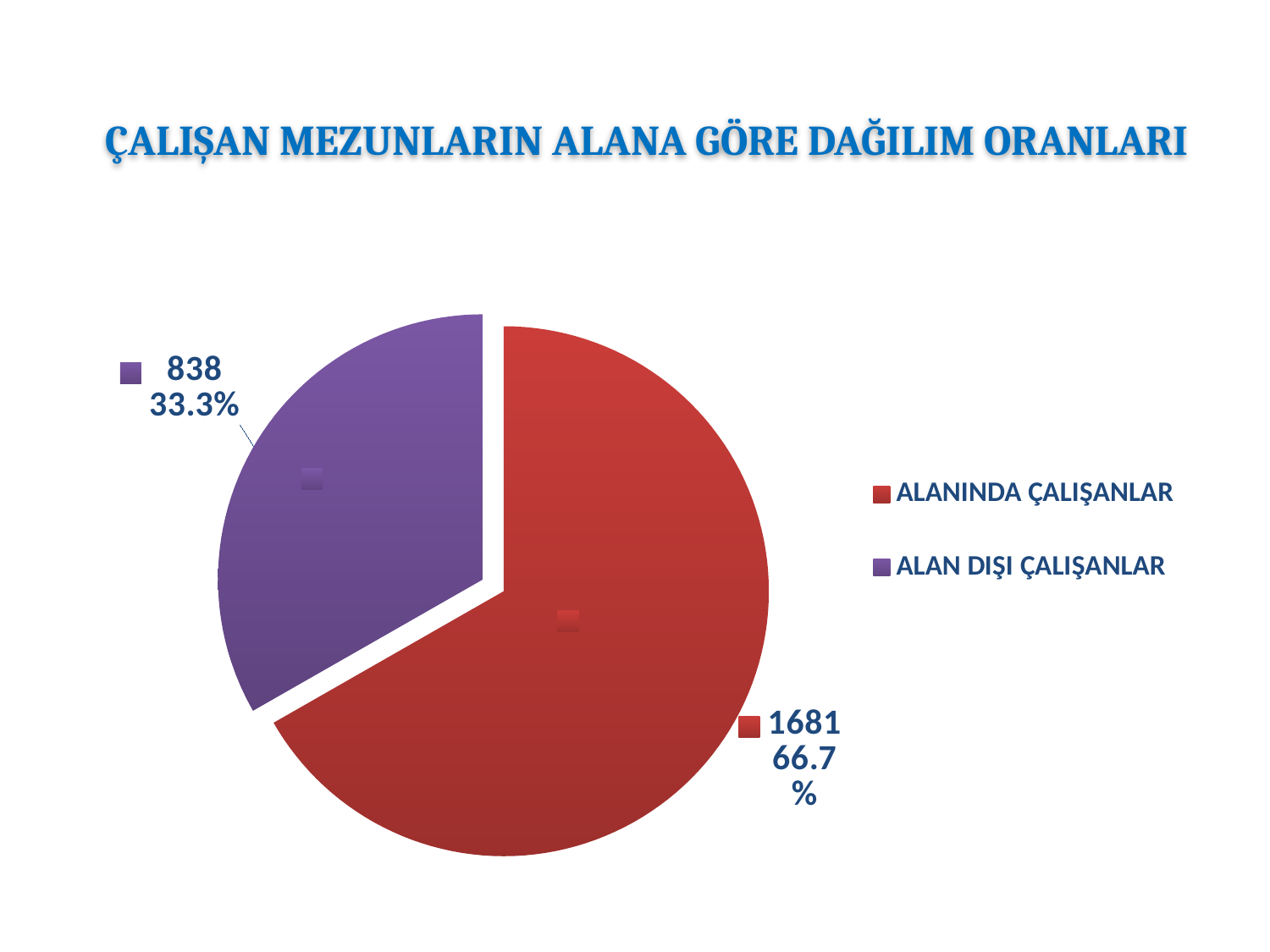
What is the difference between the values for ALANINDA ÇALIŞANLAR and ALAN DIŞI ÇALIŞANLAR? 843 How many categories does the pie chart have? 2 What is the total of the two values shown in the pie chart? 2519 What is the value for ALANINDA ÇALIŞANLAR? 1681 Which category has the largest slice? ALANINDA ÇALIŞANLAR What is the title of the chart? ÇALIŞAN MEZUNLARIN ALANA GÖRE DAĞILIM ORANLARI Which is larger, the value for ALANINDA ÇALIŞANLAR or ALAN DIŞI ÇALIŞANLAR? ALANINDA ÇALIŞANLAR What share of the pie does ALAN DIŞI ÇALIŞANLAR represent? 33.3% What kind of chart is shown on the slide? pie chart Which category has the smallest slice? ALAN DIŞI ÇALIŞANLAR What is the value for ALAN DIŞI ÇALIŞANLAR? 838 What share of the pie does ALANINDA ÇALIŞANLAR represent? 66.7%